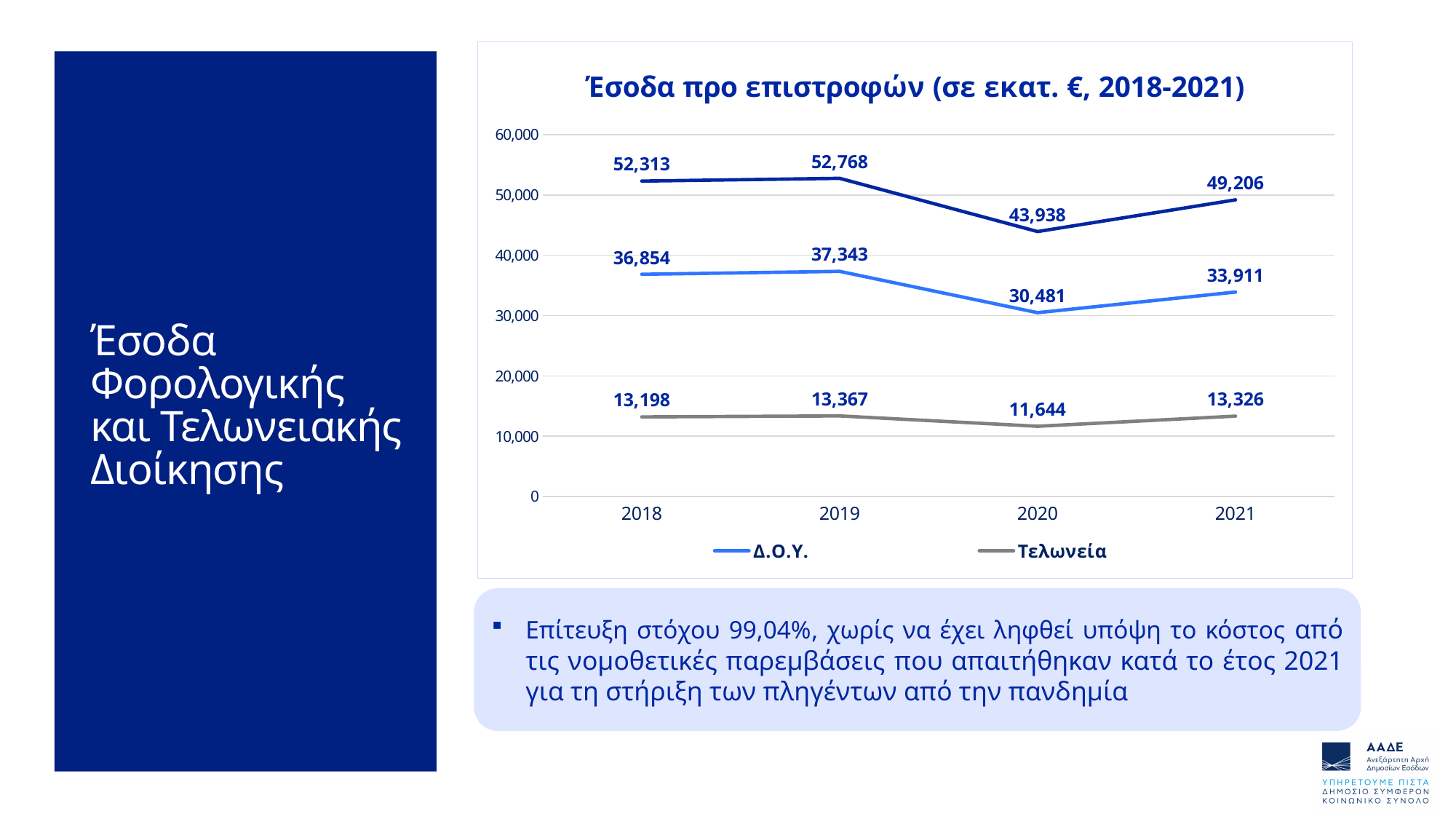
Is the Δ.Ο.Υ. value for 2021 greater or less than 30,000? greater How many series does the legend list? 2 Which is larger, the Τελωνεία value in 2018 or in 2021? 2021 How many years are shown on the x axis? 4 In which year is the Δ.Ο.Υ. value lowest? 2020 What is the title of the chart? Έσοδα προ επιστροφών (σε εκατ. €, 2018-2021) What is the value for Δ.Ο.Υ. in 2019? 37,343 What type of chart is shown on the slide? line chart In which year is the Τελωνεία value highest? 2019 What is the value for Τελωνεία in 2020? 11,644 What is the difference between the Δ.Ο.Υ. values in 2019 and 2020? 6,862 What is the value of the top (dark blue) line in 2021? 49,206